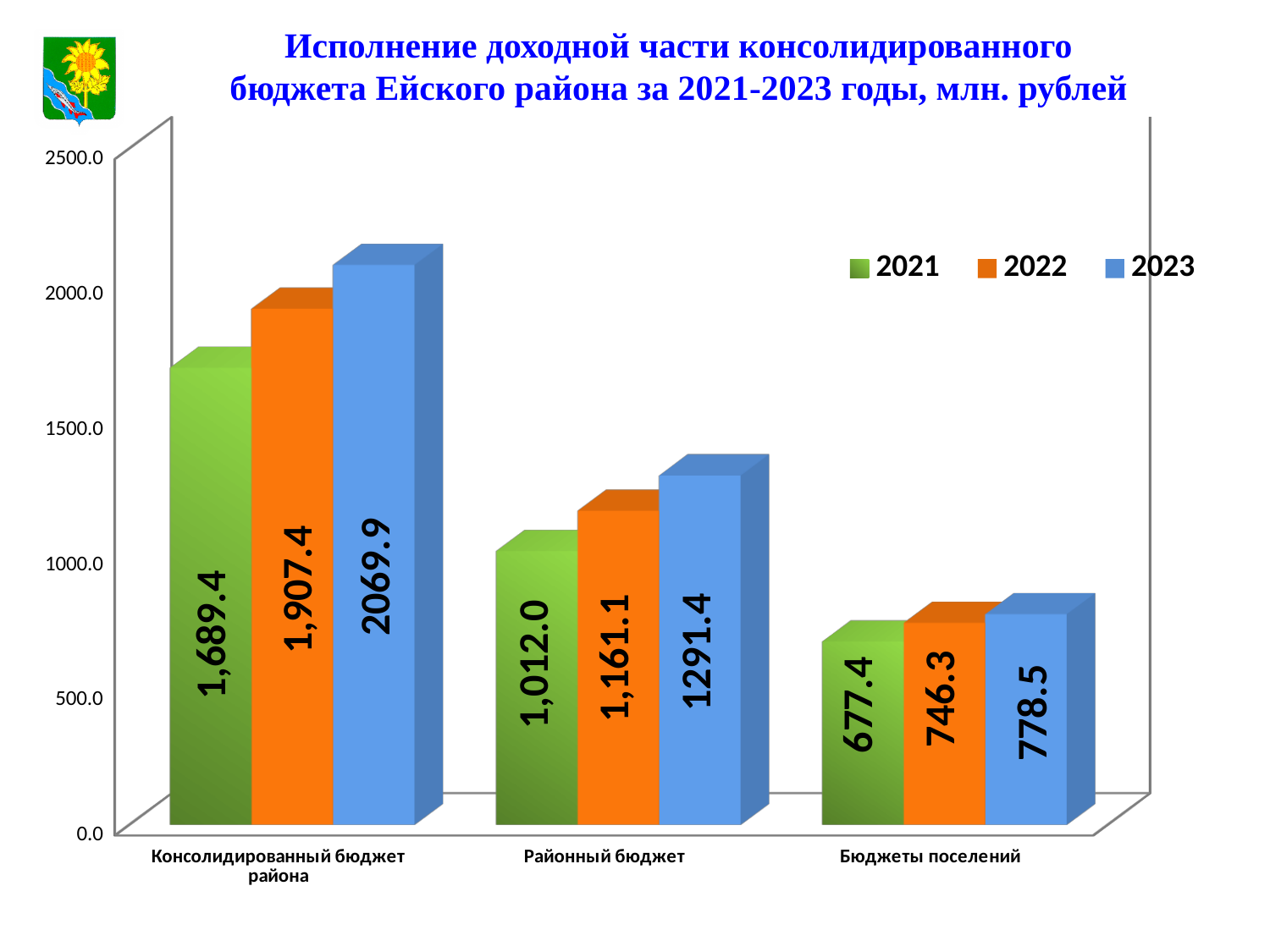
How many categories are shown on the x axis? 3 Which is larger: the 2021 value for "Консолидированный бюджет района" or the 2023 value for "Районный бюджет"? 2021 value for Консолидированный бюджет района What kind of chart is shown on the slide? bar chart Is the 2023 value for "Бюджеты поселений" greater or less than 1000.0? less Which category has the lowest value for 2021? Бюджеты поселений How many series does the legend list? 3 What is the value for 2023 in the category "Консолидированный бюджет района"? 2069.9 What is the value for 2021 in the category "Районный бюджет"? 1,012.0 What is the value for 2022 in the category "Бюджеты поселений"? 746.3 Which colour represents the 2022 series in the legend? orange What is the difference between the 2023 and 2022 values for "Районный бюджет"? 130.3 Which category has the highest value for 2022? Консолидированный бюджет района